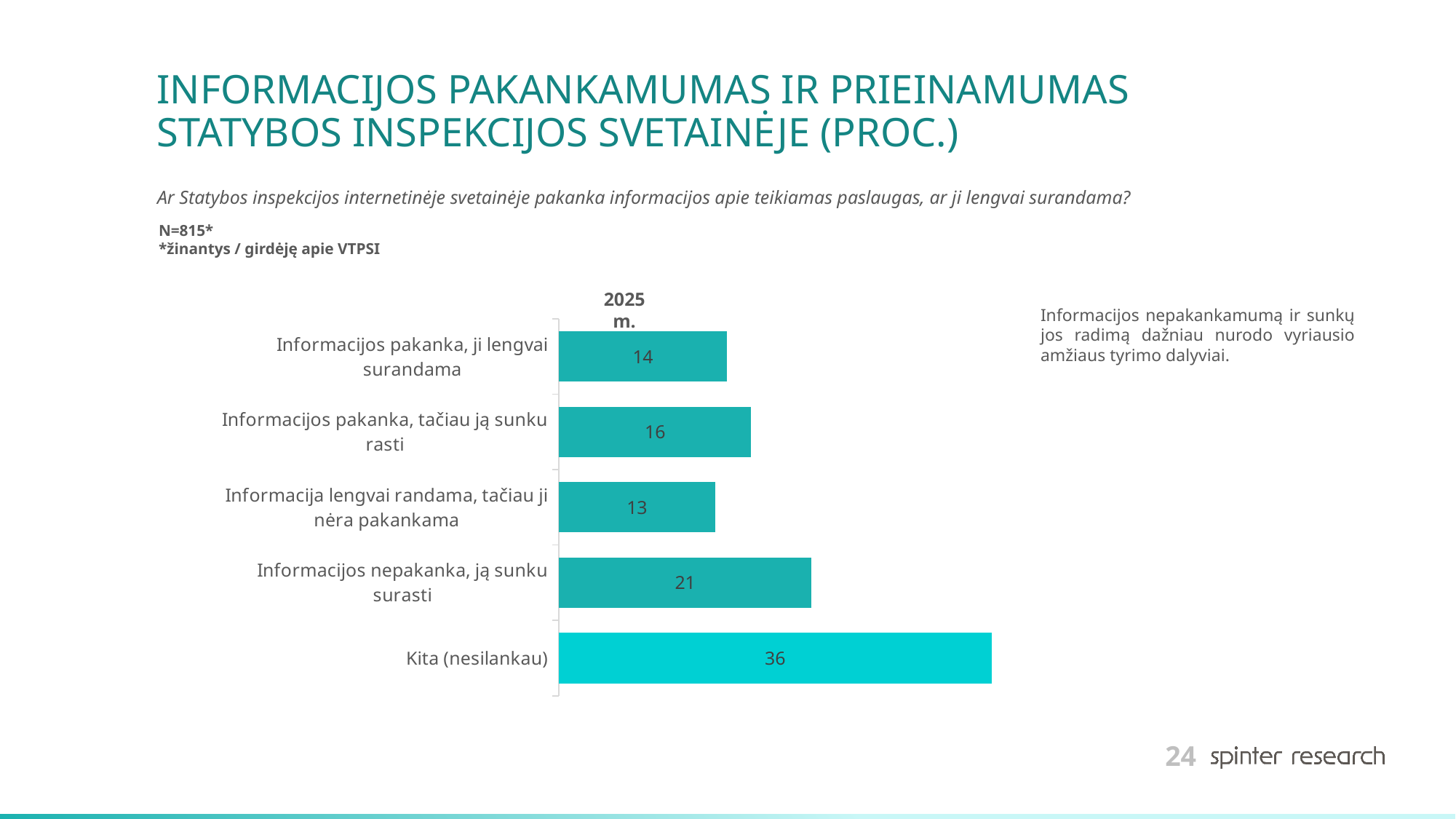
Which category has the lowest value? Informacija lengvai randama, tačiau ji nėra pakankama What is the value for "Informacija lengvai randama, tačiau ji nėra pakankama"? 13 What is the value for "Informacijos nepakanka, ją sunku surasti"? 21 Which category has the highest value? Kita (nesilankau) What is the total of the values for "Informacijos pakanka, ji lengvai surandama" and "Informacijos pakanka, tačiau ją sunku rasti"? 30 What is the value for "Informacijos pakanka, ji lengvai surandama"? 14 What year label is shown above the bars in the chart? 2025 m. What is the difference between the values for "Kita (nesilankau)" and "Informacijos nepakanka, ją sunku surasti"? 15 What kind of chart is shown on the slide? Bar chart How many categories are shown in the chart? 5 What is the value for "Kita (nesilankau)"? 36 Which is larger: the value for "Informacijos pakanka, tačiau ją sunku rasti" or for "Informacijos pakanka, ji lengvai surandama"? Informacijos pakanka, tačiau ją sunku rasti